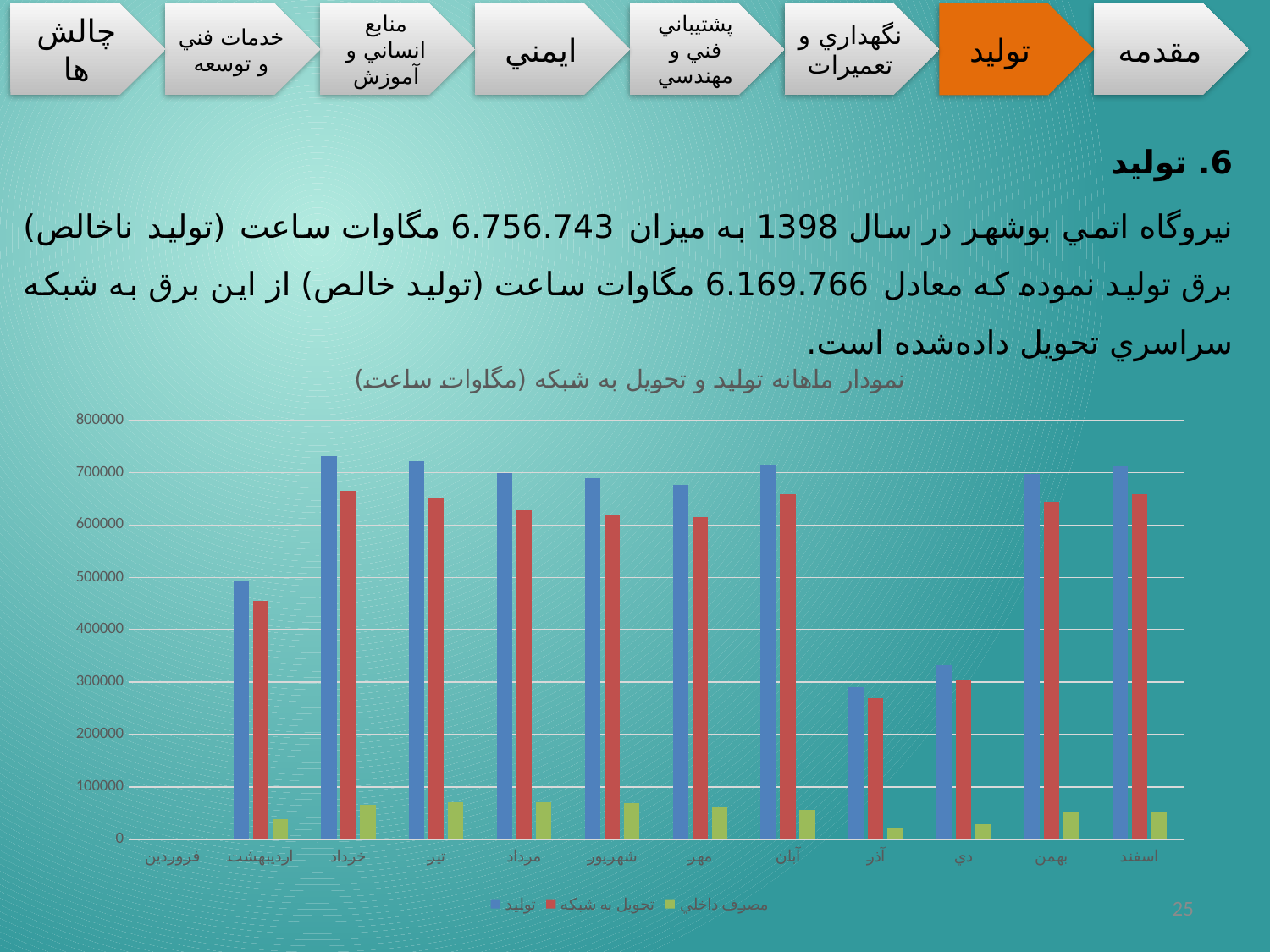
Which is larger in آبان: تولید or تحویل به شبکه? تولید Is the value of تحویل به شبکه for اردیبهشت greater or less than 500000? less Which colour represents the تولید series in the chart? blue How many series does the chart legend list? 3 What is the title of the chart? نمودار ماهانه تولید و تحویل به شبکه (مگاوات ساعت) Which month has the lowest value of تولید in the chart? فروردین Is the value of تولید for آذر greater or less than 400000? less Is the value of تولید for خرداد greater or less than 700000? greater What kind of chart is shown on the slide? bar chart Which month has the larger تولید value: آذر or دی? دی How many months (categories) are shown on the x axis of the chart? 12